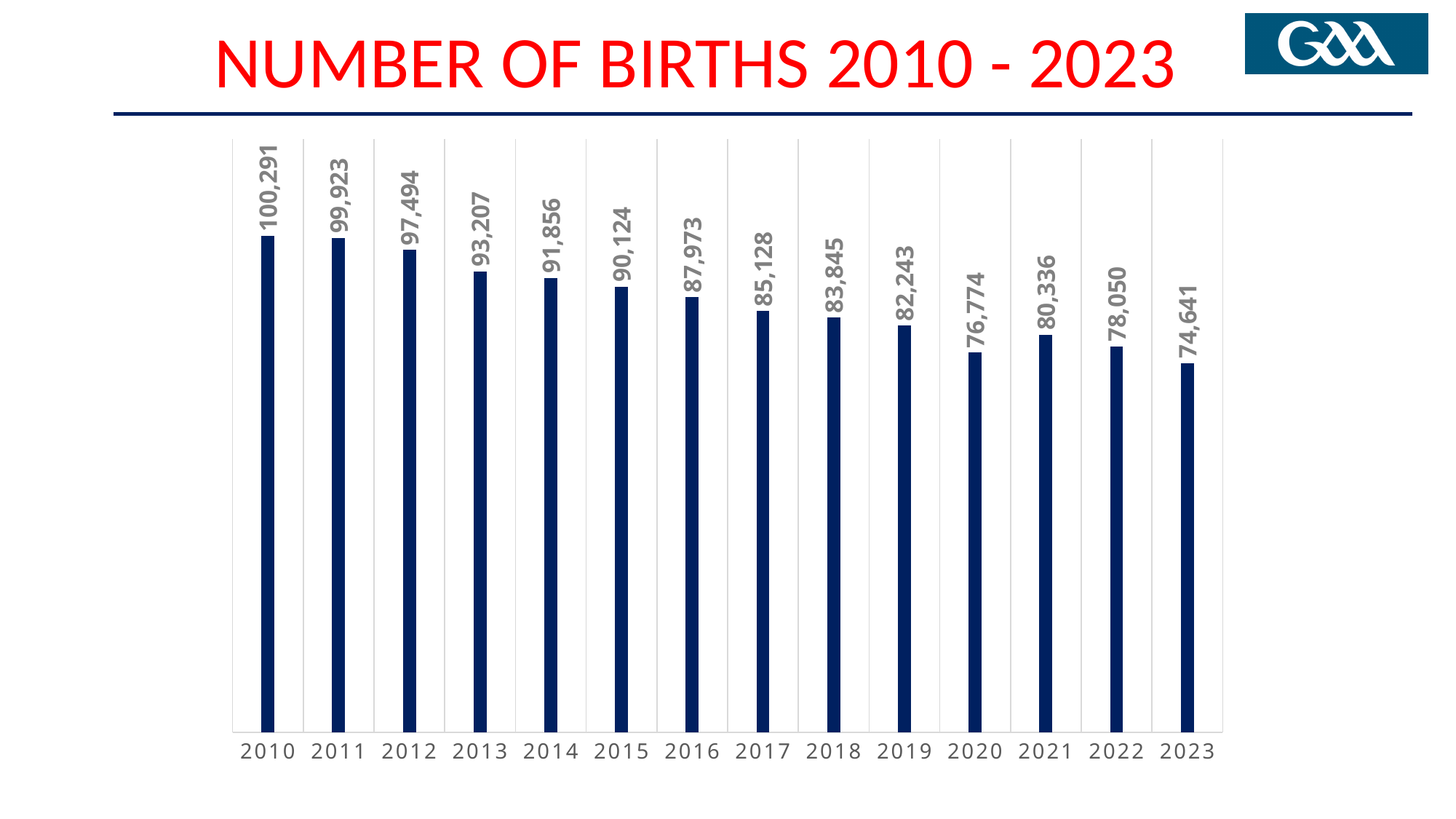
Which year has the lowest number of births? 2023 How many years are shown on the chart? 14 What is the difference in the number of births between 2010 and 2023? 25,650 What is the number of births in 2020? 76,774 What is the number of births in 2023? 74,641 What kind of chart is shown on the slide? Bar chart What is the title of the chart? NUMBER OF BIRTHS 2010 - 2023 What is the number of births in 2016? 87,973 Which year had more births, 2020 or 2021? 2021 Which year has the highest number of births? 2010 What is the difference in the number of births between 2020 and 2021? 3,562 What is the number of births in 2010? 100,291